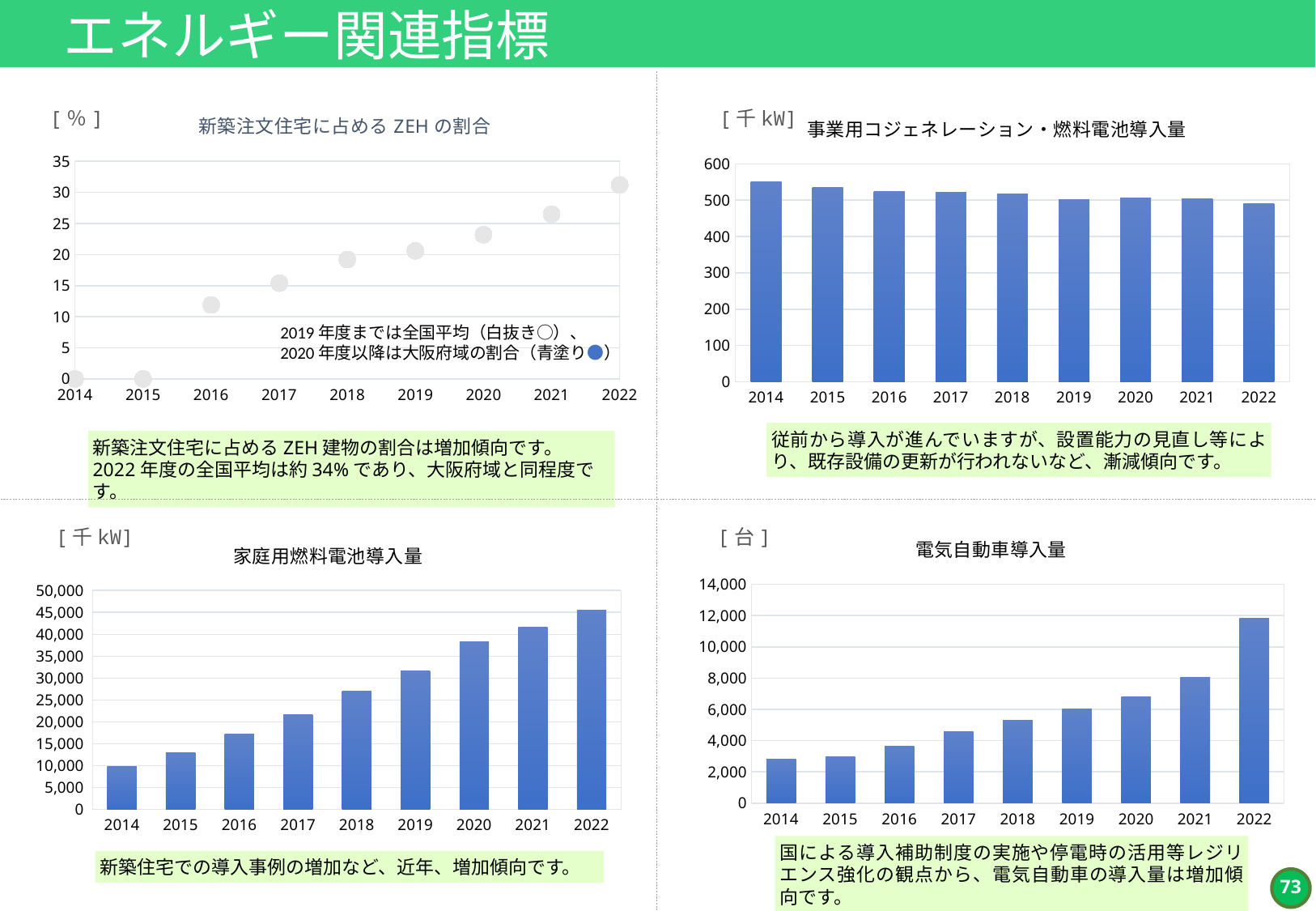
In the chart titled 家庭用燃料電池導入量, what kind of chart is it? bar chart In the chart titled 新築注文住宅に占める ZEH の割合, is the value for 2022 greater or less than 30? greater In the chart titled 電気自動車導入量, which is larger, the value for 2016 or the value for 2017? 2017 In the chart titled 新築注文住宅に占める ZEH の割合, do the values generally rise or fall from 2014 to 2022? rise In the chart titled 家庭用燃料電池導入量, is the value for 2018 greater or less than 25,000? greater In the chart titled 事業用コジェネレーション・燃料電池導入量, how many years are plotted? 9 In the chart titled 事業用コジェネレーション・燃料電池導入量, is the value for 2022 greater or less than 500? less In the chart titled 事業用コジェネレーション・燃料電池導入量, which year has the highest value? 2014 In the chart titled 事業用コジェネレーション・燃料電池導入量, which year has the lowest value? 2022 In the chart titled 新築注文住宅に占める ZEH の割合, which year has the highest value? 2022 In the chart titled 家庭用燃料電池導入量, which year has the lowest value? 2014